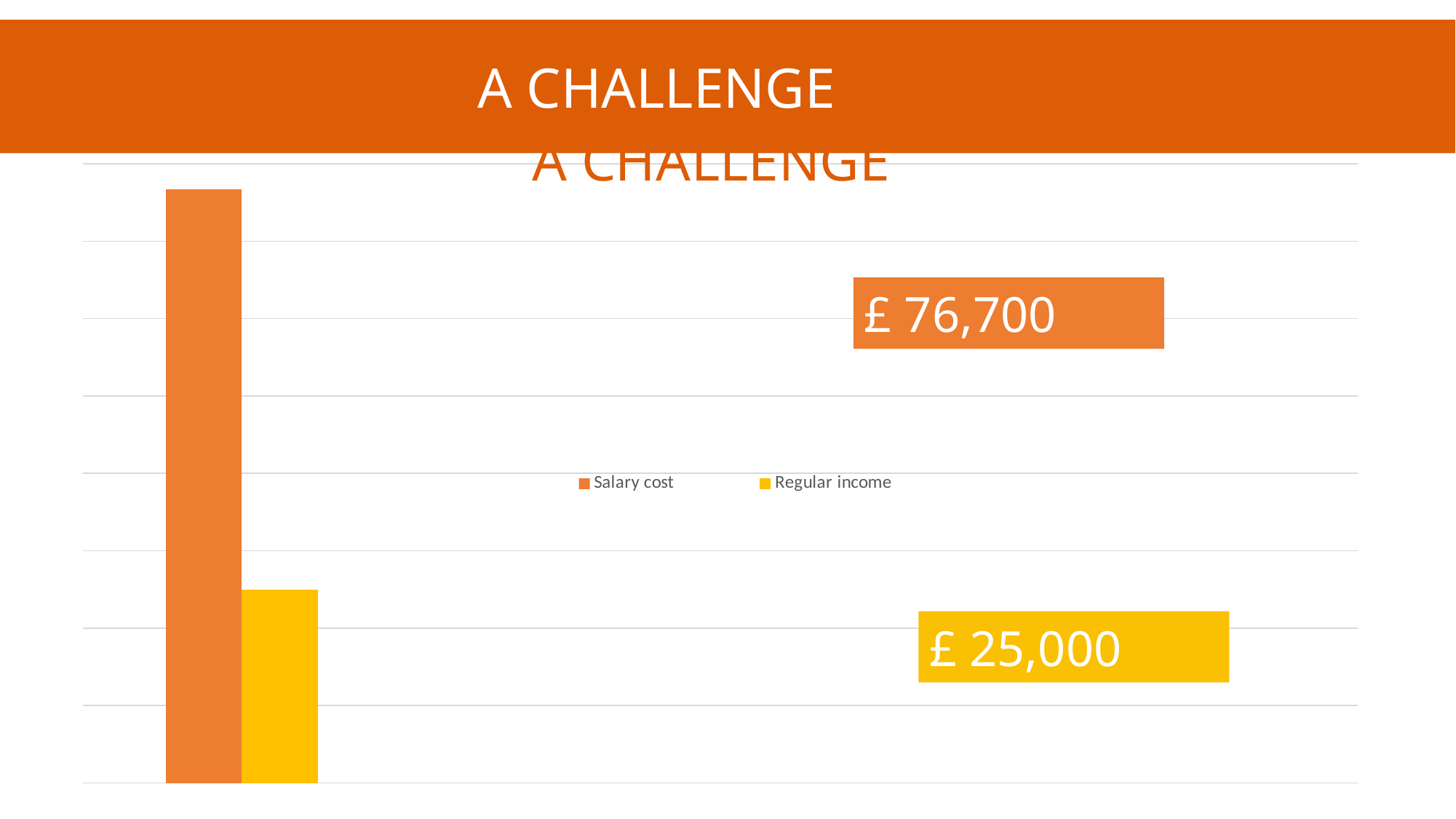
Which series has the highest value? Salary cost How many bars are plotted on the chart? 2 What is the difference between Salary cost and Regular income? £ 51,700 Which series has the higher value, Salary cost or Regular income? Salary cost What value is shown for Regular income? £ 25,000 What is the title of the chart? A CHALLENGE What value is shown for Salary cost? £ 76,700 How many series does the chart legend list? 2 What kind of chart is shown on the slide? bar chart Which series has the lowest value? Regular income What are the two series named in the legend? Salary cost and Regular income